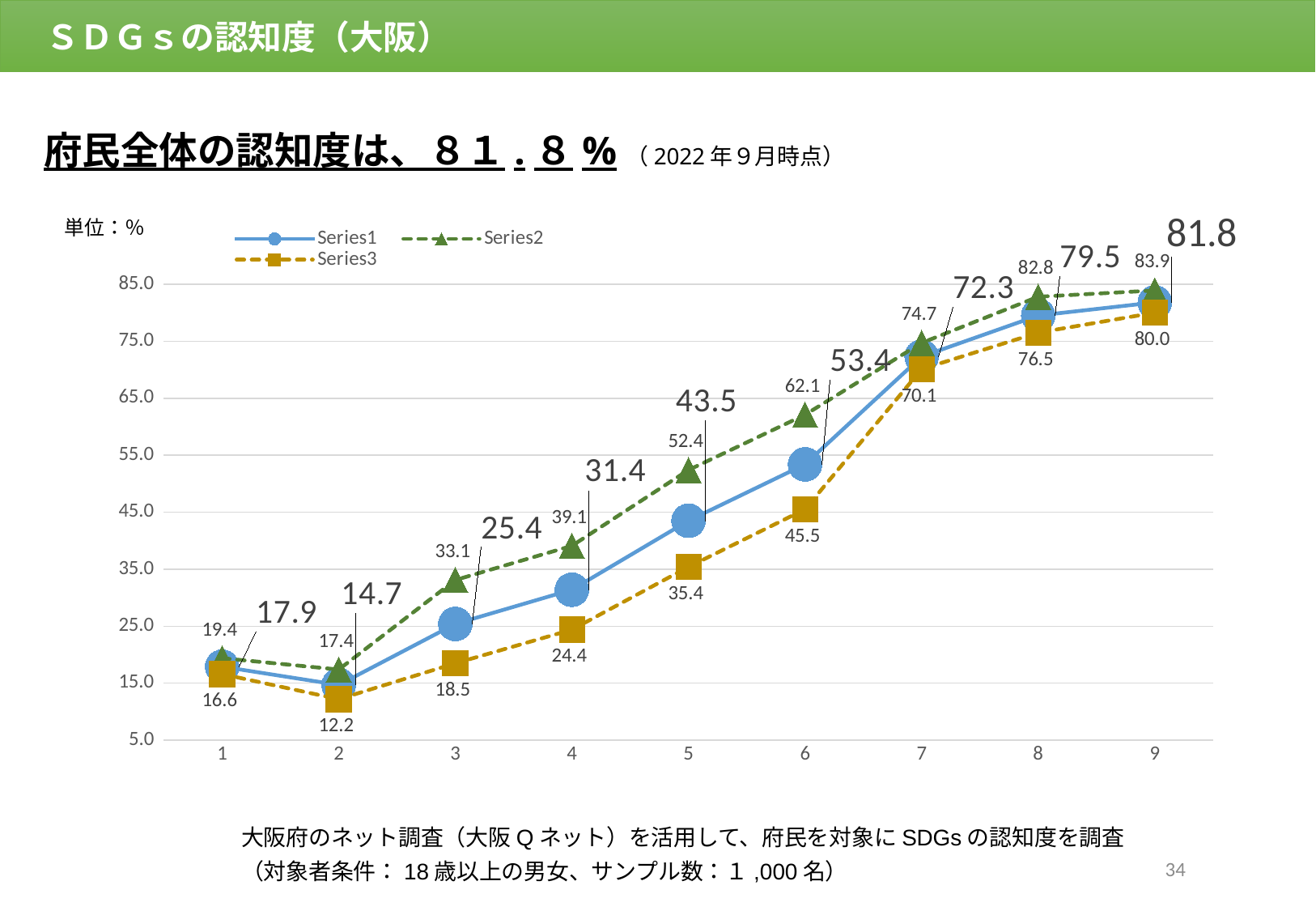
What is the difference between Series2 and Series3 at point 6? 16.6 How many points are on the x axis? 9 What kind of chart is shown? line chart Which is larger at point 4: Series1 or Series3? Series1 Is the value of Series3 at point 7 greater or less than 65.0? greater At which x-axis point is Series1 lowest? 2 At which x-axis point is Series2 highest? 9 What is the value of Series1 at point 9? 81.8 How many series does the legend list? 3 What is the value of Series2 at point 5? 52.4 Do the Series1 values generally rise or fall from point 2 to point 9? rise What is the value of Series3 at point 2? 12.2